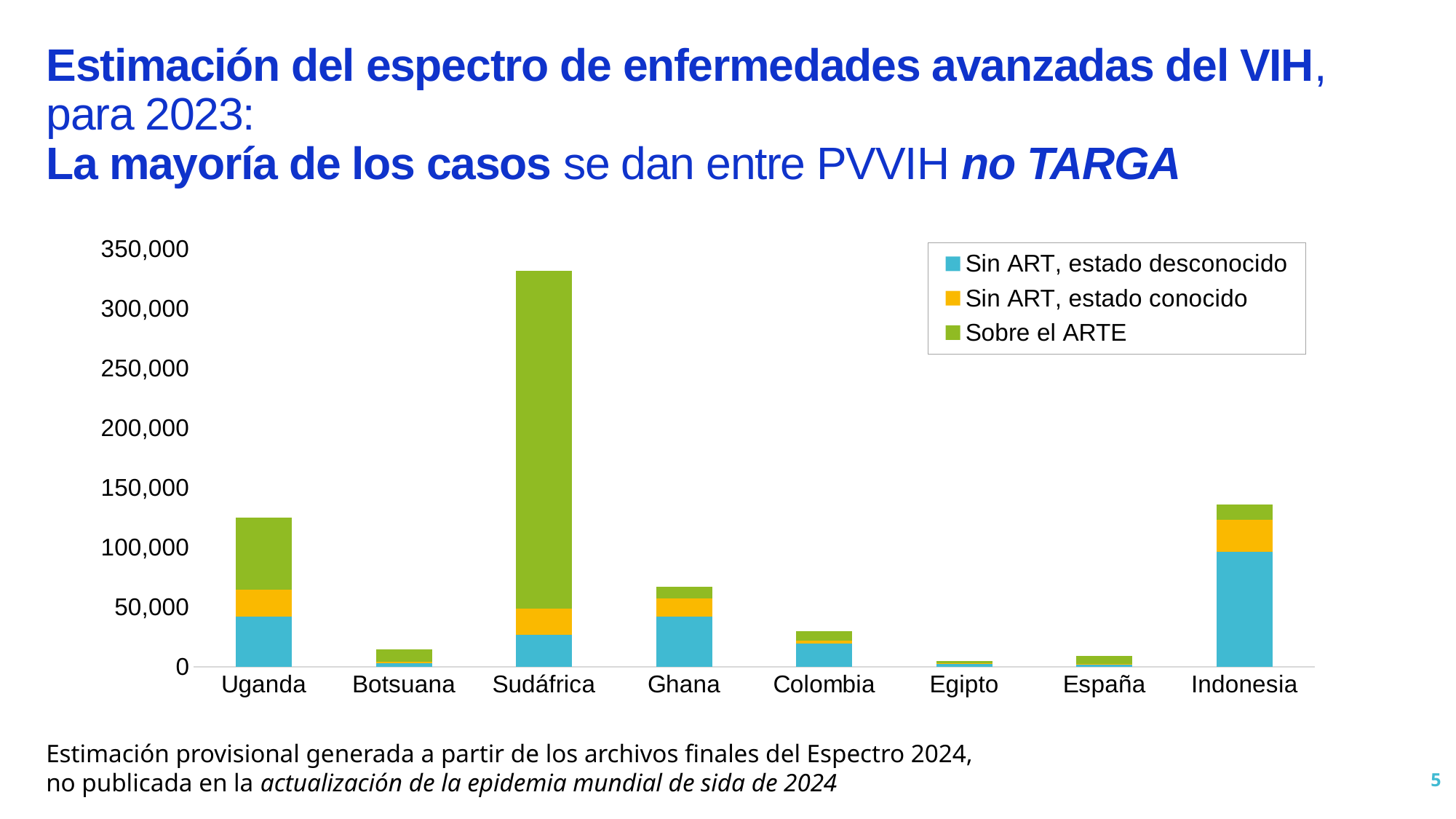
What kind of chart is shown on the slide? Stacked bar chart Which colour represents the series "Sobre el ARTE" in the legend? Green Is the total stacked bar for Sudáfrica greater or less than 300,000? greater Which country has the tallest stacked bar in the chart? Sudáfrica Which country has a taller stacked bar, Ghana or Colombia? Ghana How many countries are shown on the x axis of the chart? 8 Which country has the shortest stacked bar in the chart? Egipto How many series does the chart's legend list? 3 Is the total stacked bar for Botsuana greater or less than 50,000? less Which country has a taller stacked bar, Indonesia or Uganda? Indonesia Is the total stacked bar for Uganda greater or less than 100,000? greater